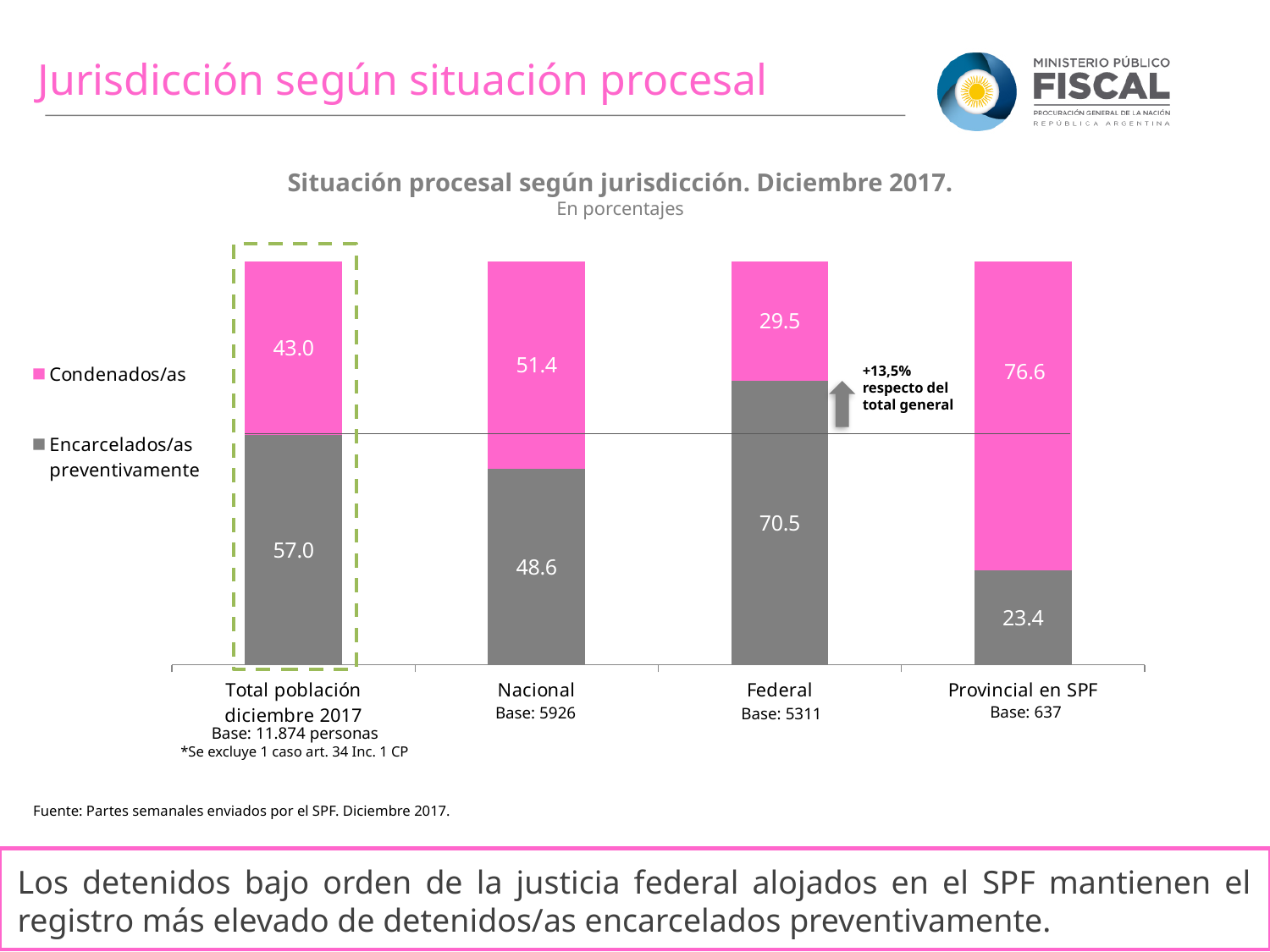
What is the difference between the Encarcelados/as preventivamente value for Federal and for Nacional? 21.9 What is the total of the stacked bar for Provincial en SPF? 100.0 What kind of chart is shown on the slide? Stacked bar chart How many series does the legend list? 2 What is the value for Condenados/as in the Provincial en SPF category? 76.6 What is the value for Encarcelados/as preventivamente in the Total población diciembre 2017 category? 57.0 How many categories are shown on the x axis? 4 What is the value for Condenados/as in the Nacional category? 51.4 Which category has the highest value for Encarcelados/as preventivamente? Federal What is the value for Encarcelados/as preventivamente in the Federal category? 70.5 Which is larger: the Condenados/as value for Nacional or for Total población diciembre 2017? Nacional Which category has the lowest value for Condenados/as? Federal